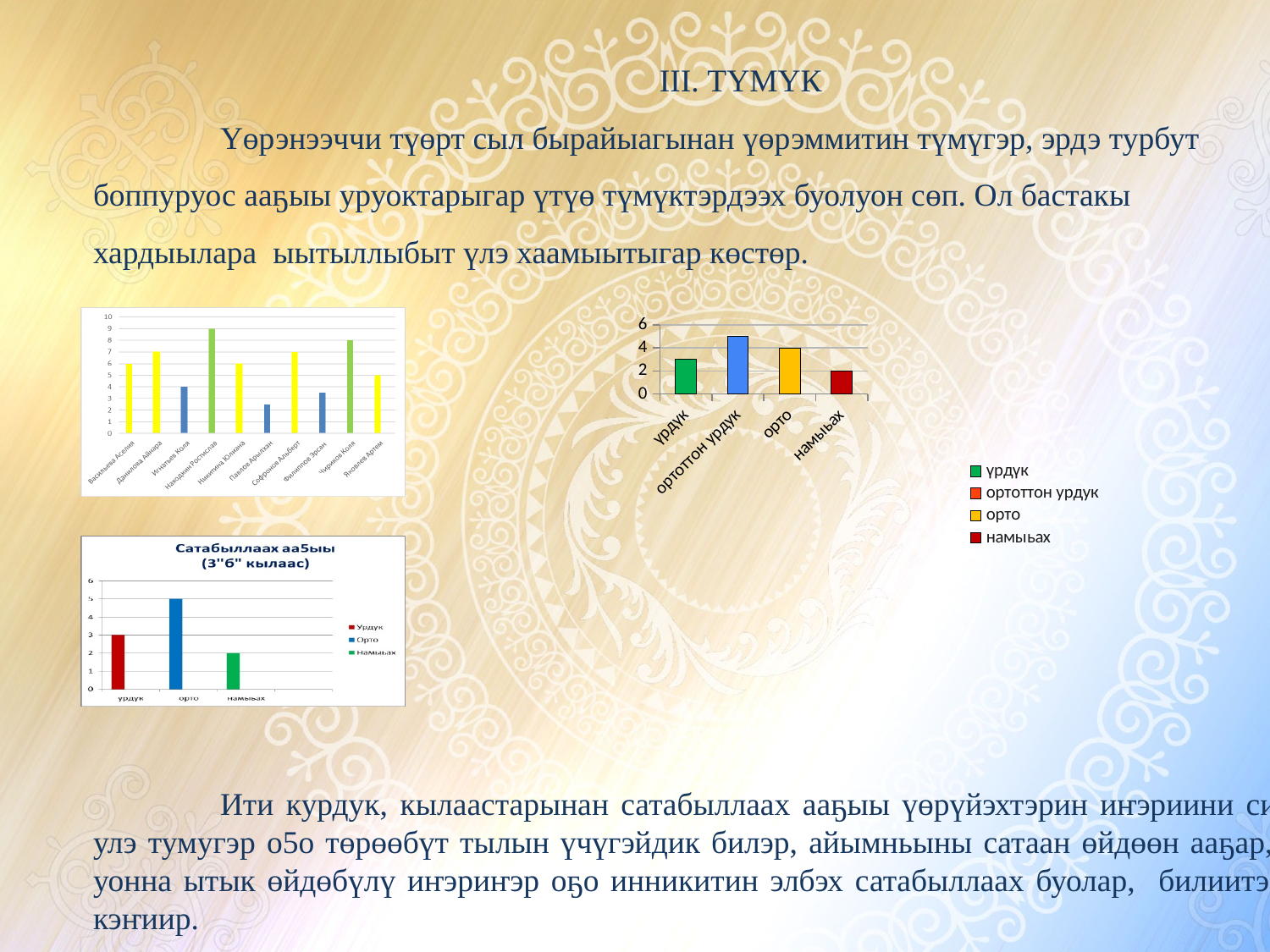
What kind of chart is the chart titled 'Сатабыллаах аа5ыы (3"б" кылаас)'? bar chart On the chart titled 'Сатабыллаах аа5ыы (3"б" кылаас)', what is the value for урдук? 3 On the right-hand chart, is the value for ортоттон урдук greater or less than 4? greater On the chart titled 'Сатабыллаах аа5ыы (3"б" кылаас)', what is the value for орто? 5 On the right-hand chart, is the value for үрдүк greater or less than 4? less On the right-hand chart, which category has the lowest value? намыьах On the right-hand chart, which category has the highest value? ортоттон урдук On the right-hand chart, what is the value for намыьах? 2 On the chart titled 'Сатабыллаах аа5ыы (3"б" кылаас)', what is the difference between орто and намыьах? 3 How many entries does the legend of the right-hand chart list? 4 On the right-hand chart, what is the value for орто? 4 How many bars are shown on the top-left chart? 10